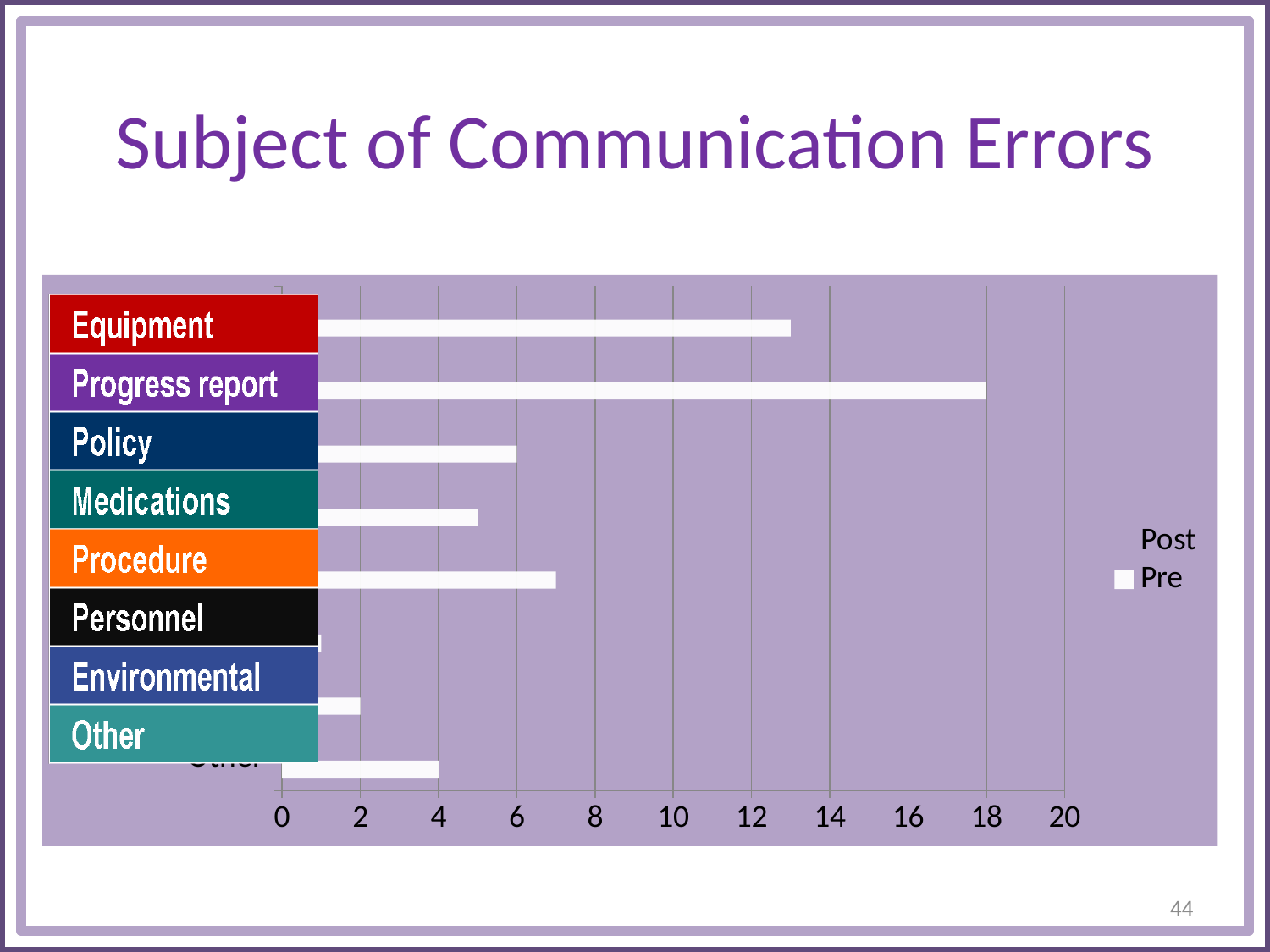
What is the Pre value for Other? 4 How many categories are shown on the chart? 8 Which has the larger Pre value, Policy or Procedure? Procedure What is the difference between the Pre values for Progress report and Policy? 12 What is the Pre value for Environmental? 2 Which category has the highest Pre value? Progress report What kind of chart is shown on the slide? bar chart Is the Pre value for Equipment greater or less than 12? greater How many series does the legend list? 2 What is the Pre value for Policy? 6 Which category has the lowest Pre value? Personnel What is the Pre value for Progress report? 18